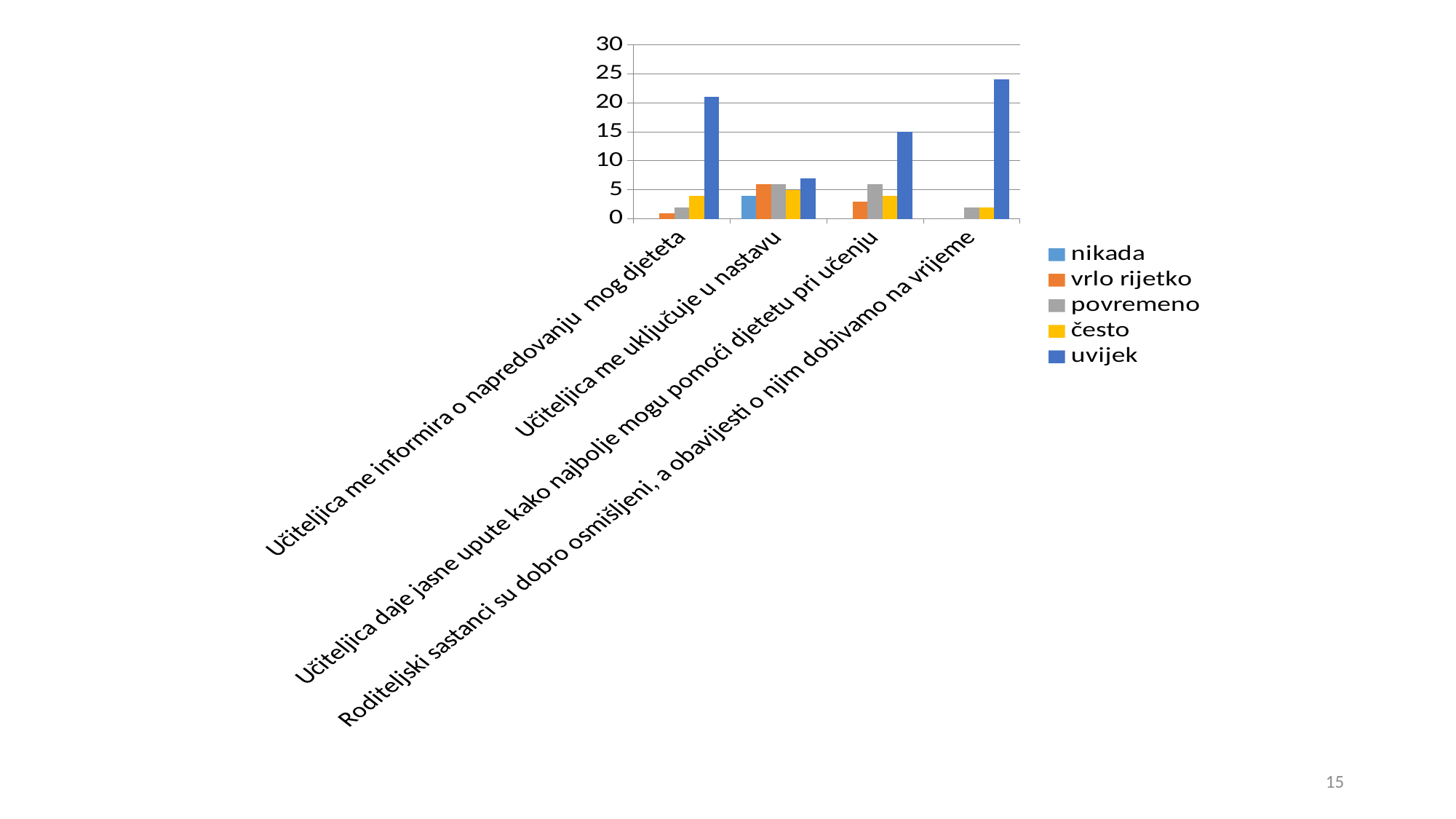
Is the value of "uvijek" for "Roditeljski sastanci su dobro osmišljeni, a obavijesti o njim dobivamo na vrijeme" greater or less than 20? greater Which category has the highest value for the "uvijek" series? Roditeljski sastanci su dobro osmišljeni, a obavijesti o njim dobivamo na vrijeme For "Učiteljica me uključuje u nastavu", which is larger: the "nikada" value or the "vrlo rijetko" value? vrlo rijetko Which category has the lowest value for the "uvijek" series? Učiteljica me uključuje u nastavu Which is larger: the "uvijek" value for "Učiteljica me informira o napredovanju mog djeteta" or for "Roditeljski sastanci su dobro osmišljeni, a obavijesti o njim dobivamo na vrijeme"? Roditeljski sastanci su dobro osmišljeni, a obavijesti o njim dobivamo na vrijeme Is the value of "uvijek" for "Učiteljica me uključuje u nastavu" greater or less than 10? less What is the value of "uvijek" for "Učiteljica daje jasne upute kako najbolje mogu pomoći djetetu pri učenju"? 15 Is the value of "uvijek" for "Učiteljica me informira o napredovanju mog djeteta" greater or less than 15? greater What colour represents the "uvijek" series in the legend? dark blue How many categories are shown on the x axis? 4 What type of chart is shown on the slide? bar chart How many series does the legend list? 5